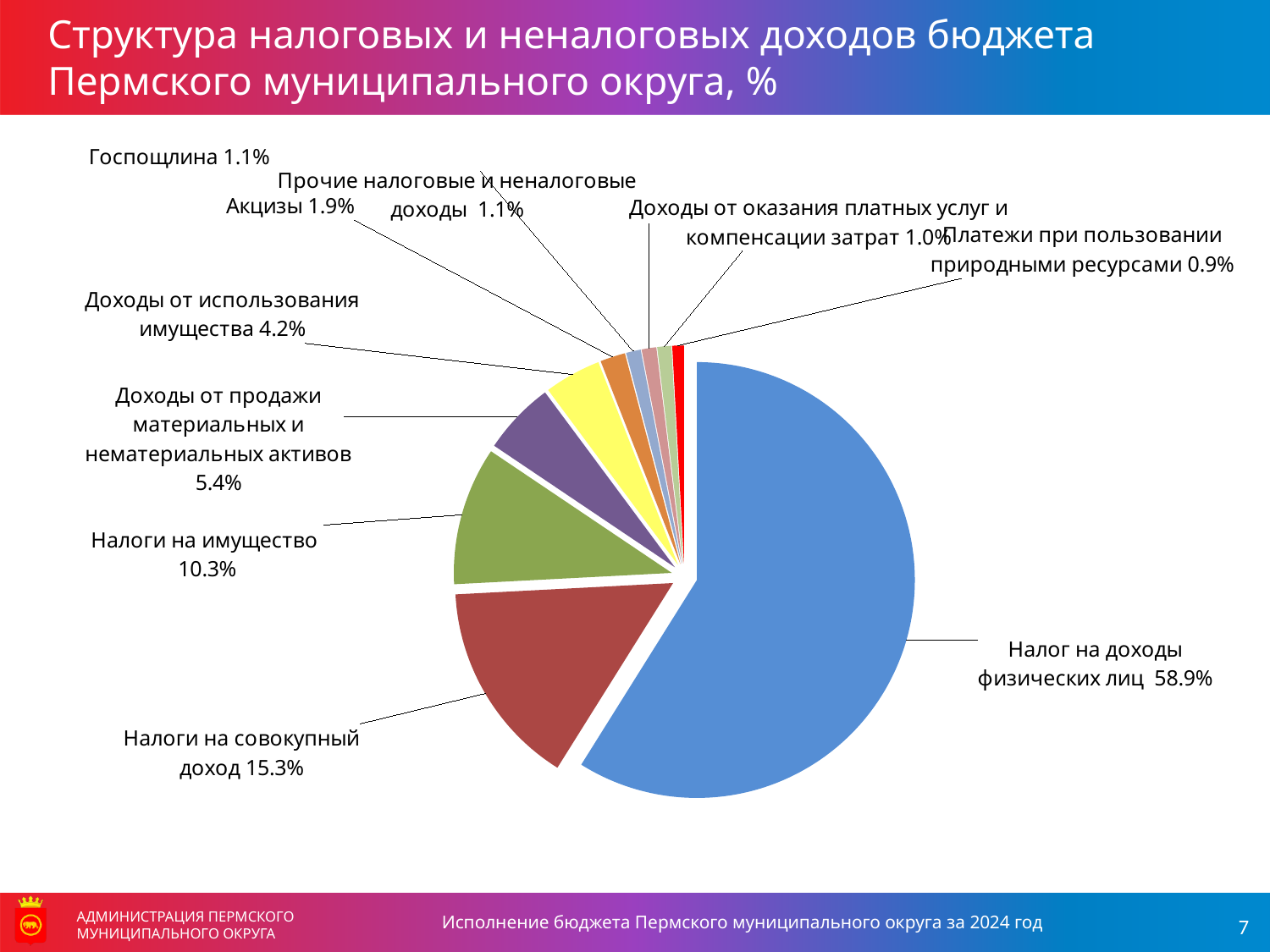
What is the value for "Налоги на имущество"? 10.3% How many slices does the pie chart have? 10 What is the value for "Акцизы"? 1.9% What share of the pie does "Налог на доходы физических лиц" have? 58.9% What kind of chart is shown on the slide? pie chart Which category has the smallest slice of the pie? Платежи при пользовании природными ресурсами What is the value for "Доходы от использования имущества"? 4.2% What is the difference between "Налоги на совокупный доход" and "Налоги на имущество"? 5.0% Which is larger: "Доходы от продажи материальных и нематериальных активов" or "Доходы от использования имущества"? Доходы от продажи материальных и нематериальных активов What is the value for "Налоги на совокупный доход"? 15.3% Which category has the largest slice of the pie? Налог на доходы физических лиц What is the title of the chart on the slide? Структура налоговых и неналоговых доходов бюджета Пермского муниципального округа, %